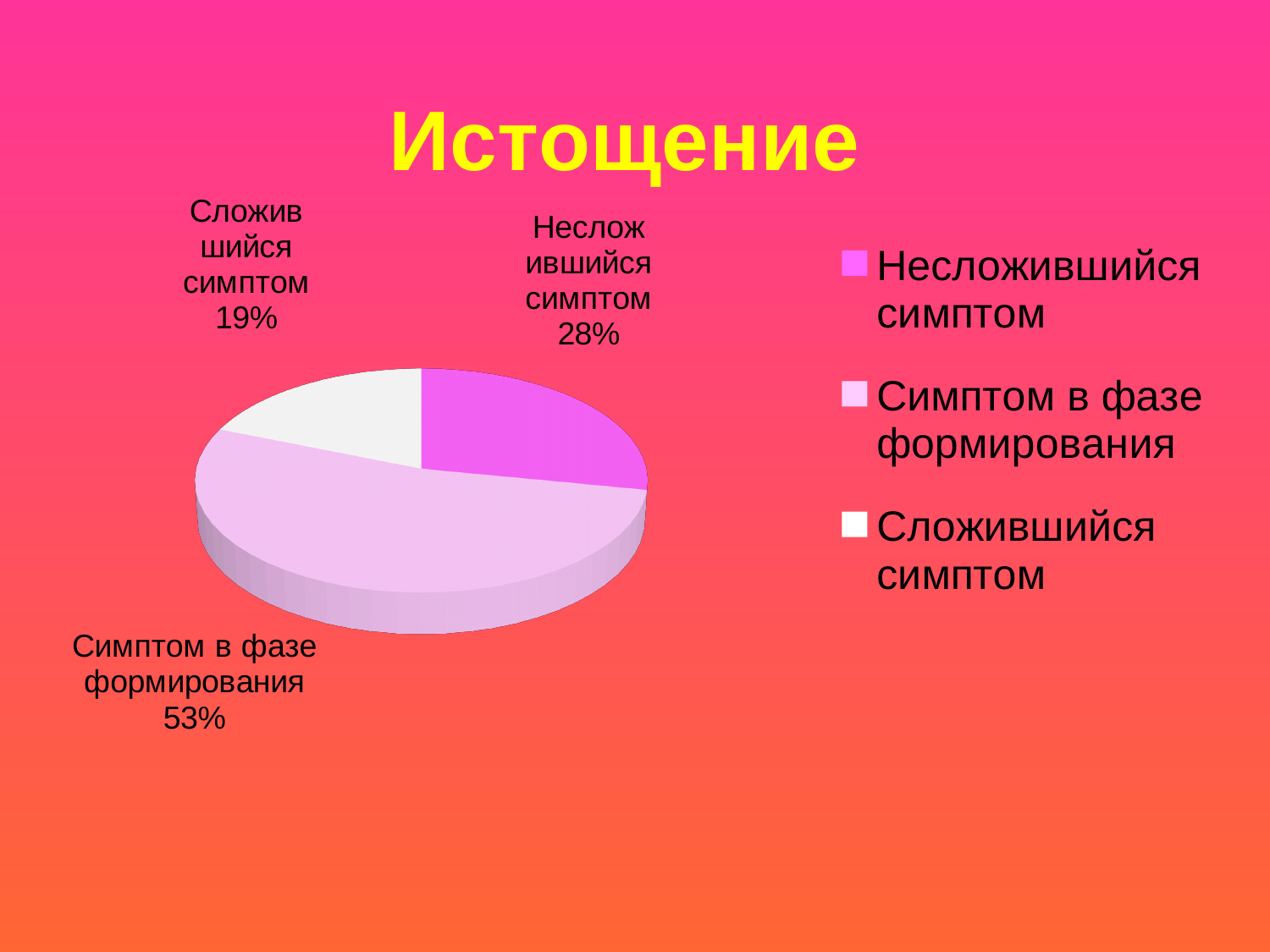
Which is larger: "Несложившийся симптом" or "Сложившийся симптом"? Несложившийся симптом Which category has the largest slice of the pie? Симптом в фазе формирования What share of the pie does "Сложившийся симптом" have? 19% What is the title of the chart? Истощение What colour is the slice for "Сложившийся симптом"? white What type of chart is shown on the slide? pie chart How many slices does the pie chart have? 3 How many entries does the legend list? 3 Which category has the smallest slice of the pie? Сложившийся симптом What share of the pie does "Несложившийся симптом" have? 28% What is the difference in percentage points between "Симптом в фазе формирования" and "Несложившийся симптом"? 25 What share of the pie does "Симптом в фазе формирования" have? 53%